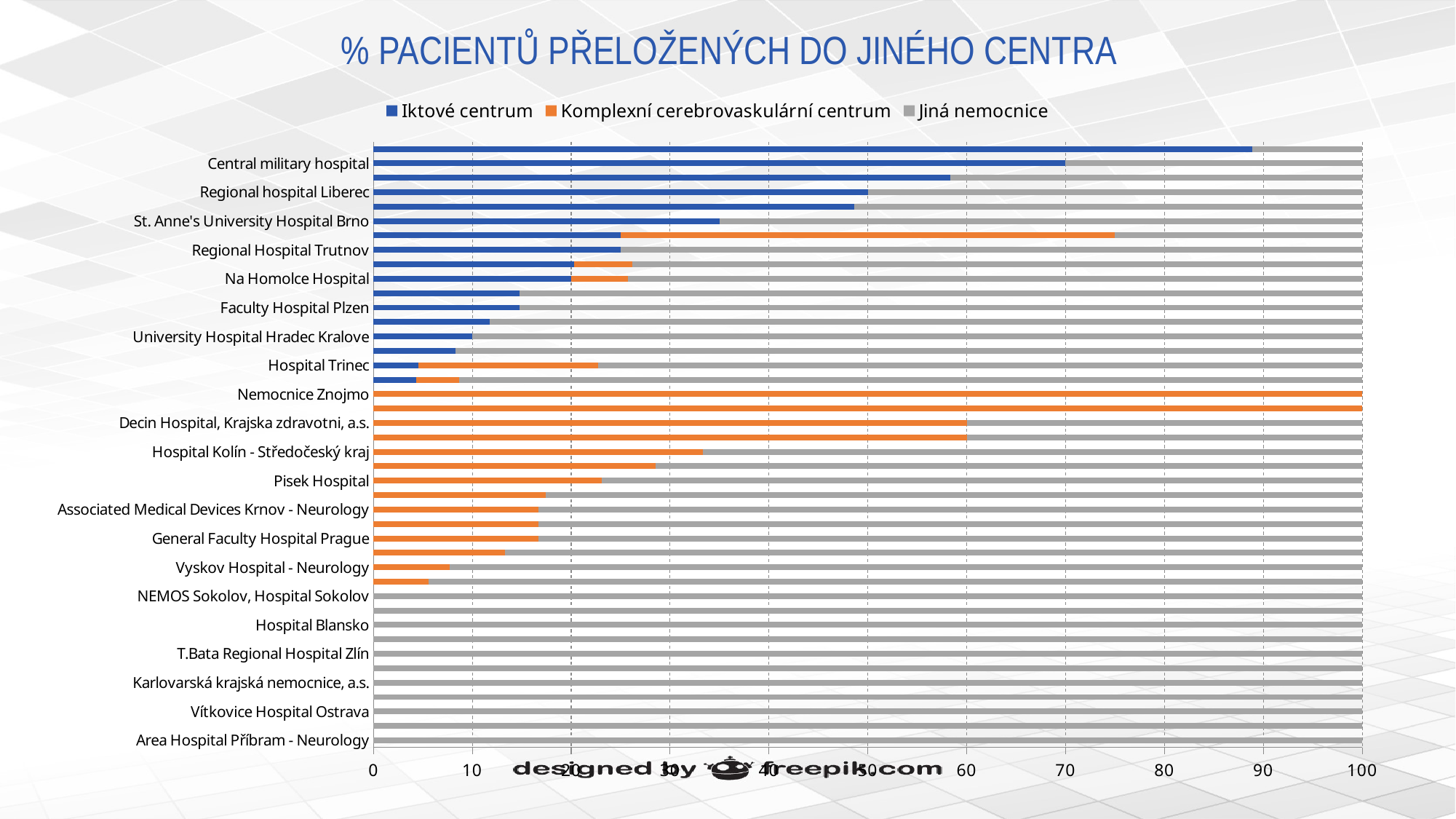
What is the Komplexní cerebrovaskulární centrum value for Nemocnice Znojmo? 100 What is the Jiná nemocnice value for Area Hospital Příbram - Neurology? 100 What kind of chart is shown on the slide? bar chart Is the Iktové centrum value for St. Anne's University Hospital Brno greater or less than 40? less Is the Iktové centrum value for Central military hospital greater or less than 60? greater Is the Komplexní cerebrovaskulární centrum value for Hospital Kolín - Středočeský kraj greater or less than 30? greater How many series does the legend list? 3 Which series is shown in orange in the legend? Komplexní cerebrovaskulární centrum Do the Iktové centrum values rise or fall going down the list of hospitals from Central military hospital to Hospital Trinec? fall What is the title of the chart? % PACIENTŮ PŘELOŽENÝCH DO JINÉHO CENTRA Which has the larger Iktové centrum value, Central military hospital or St. Anne's University Hospital Brno? Central military hospital